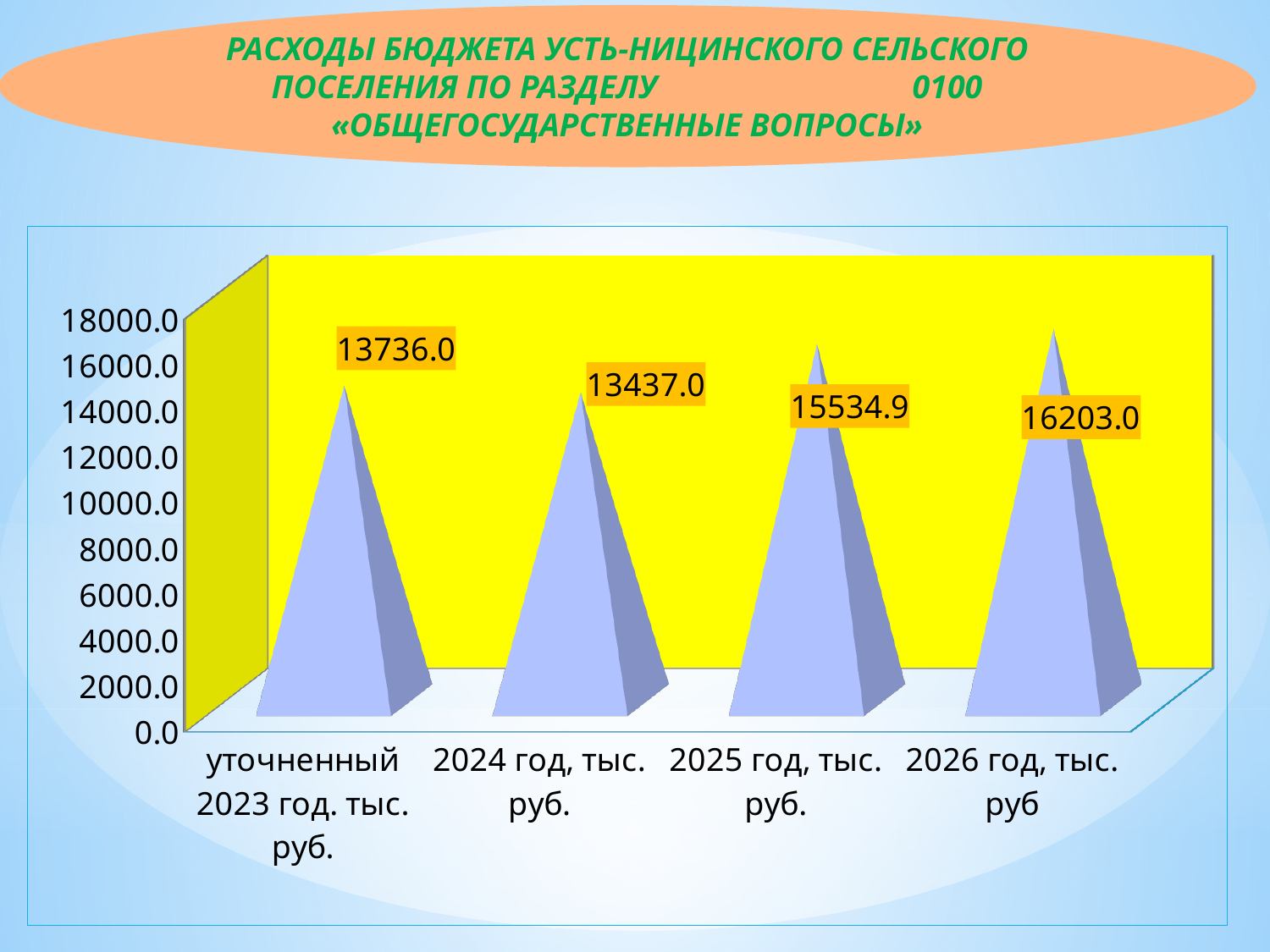
What is the difference between the values for 2025 год, тыс. руб. and 2024 год, тыс. руб.? 2097.9 What is the value for 2024 год, тыс. руб.? 13437.0 How many categories are shown on the chart? 4 Which is larger, the value for 2025 год, тыс. руб. or the value for уточненный 2023 год. тыс. руб.? 2025 год, тыс. руб. Which category has the lowest value? 2024 год, тыс. руб. What is the value for уточненный 2023 год. тыс. руб.? 13736.0 What kind of chart is shown on the slide? bar chart What is the difference between the values for 2026 год, тыс. руб and уточненный 2023 год. тыс. руб.? 2467.0 Which category has the highest value? 2026 год, тыс. руб What is the value for 2025 год, тыс. руб.? 15534.9 What is the value for 2026 год, тыс. руб? 16203.0 Is the value for 2025 год, тыс. руб. greater or less than 14000.0? greater